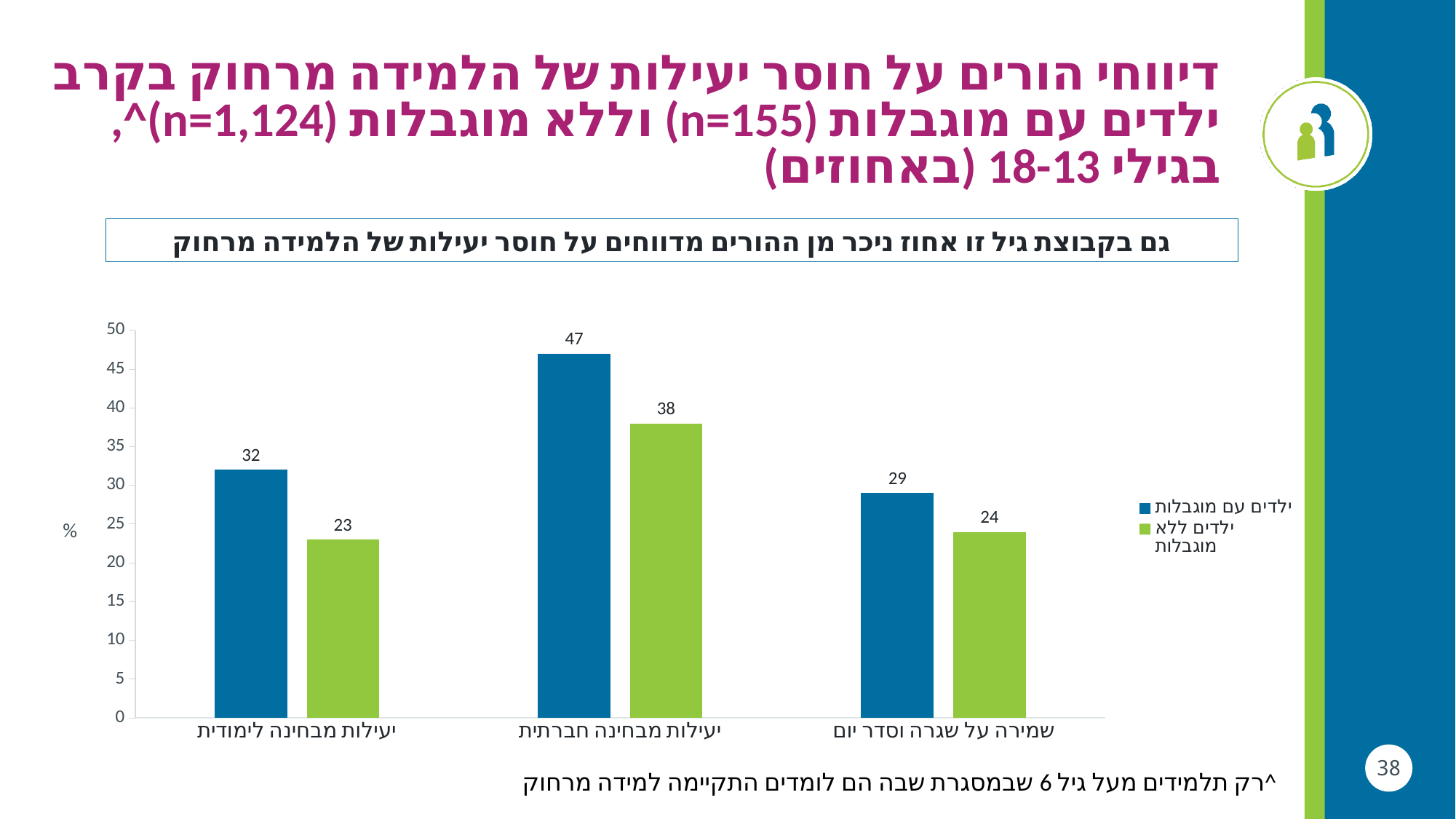
What is the value for ילדים ללא מוגבלות in the category יעילות מבחינה לימודית? 23 Which category has the lowest value for ילדים ללא מוגבלות? יעילות מבחינה לימודית What is the difference between ילדים עם מוגבלות and ילדים ללא מוגבלות in the category יעילות מבחינה לימודית? 9 How many series does the legend list? 2 What is the value for ילדים עם מוגבלות in the category יעילות מבחינה חברתית? 47 How many categories are shown on the x axis of the chart? 3 What kind of chart is shown on the slide? bar chart Which category has the highest value for ילדים עם מוגבלות? יעילות מבחינה חברתית Which is larger: the value for ילדים עם מוגבלות in שמירה על שגרה וסדר יום or the value for ילדים עם מוגבלות in יעילות מבחינה לימודית? יעילות מבחינה לימודית Which colour represents the series ילדים ללא מוגבלות in the chart? green What is the difference between ילדים עם מוגבלות and ילדים ללא מוגבלות in the category יעילות מבחינה חברתית? 9 What is the value for ילדים ללא מוגבלות in the category שמירה על שגרה וסדר יום? 24